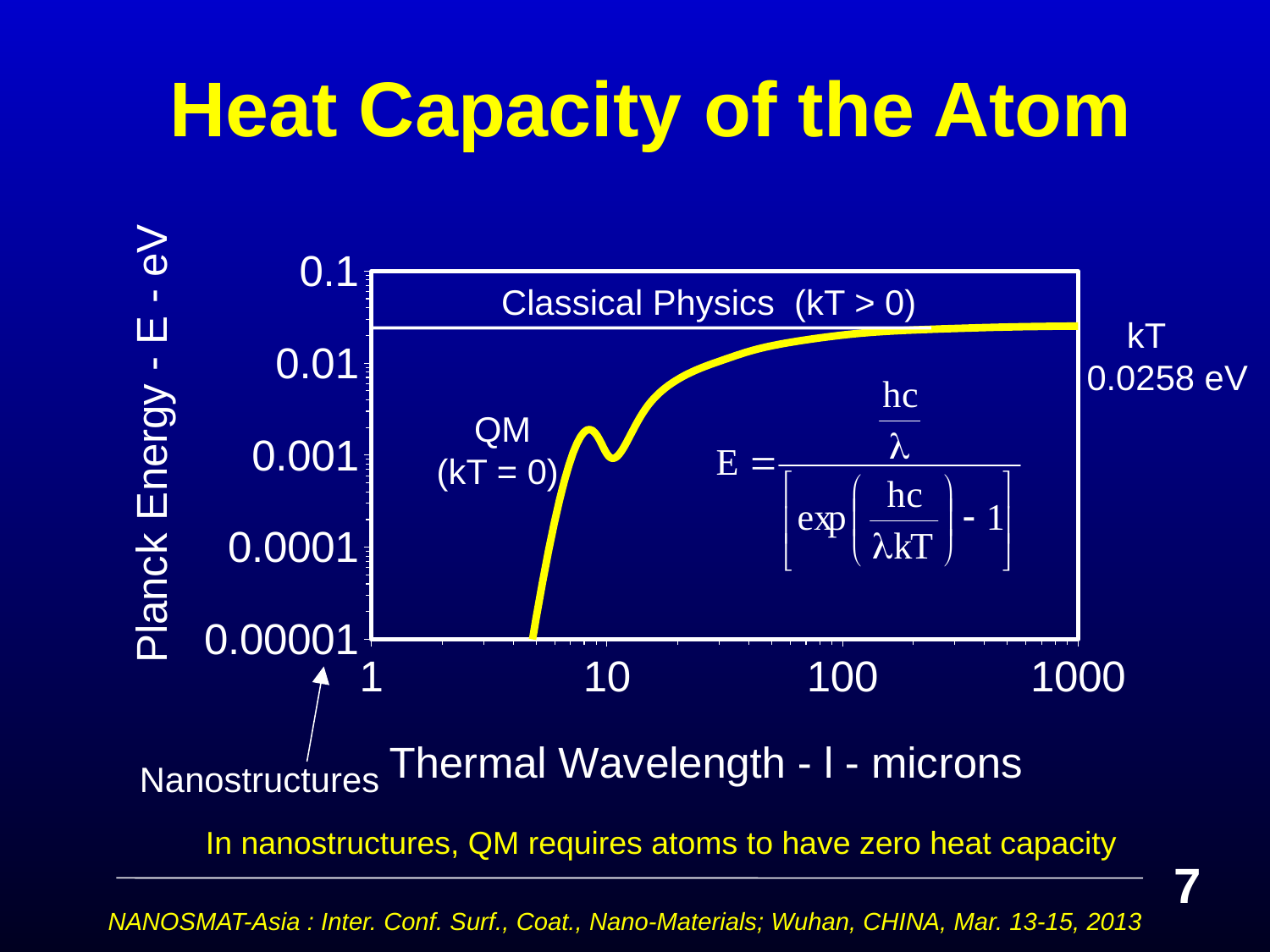
Is the Planck energy at a thermal wavelength of 10 microns greater or less than 0.01 eV? less Is the Planck energy at a thermal wavelength of 1000 microns greater or less than 0.1 eV? less What value of kT is printed next to the horizontal line on the chart? 0.0258 eV What is the label of the y axis of the chart? Planck Energy - E - eV How many labelled tick values are shown on the x axis of the chart? 4 Is the Planck energy at a thermal wavelength of 1000 microns greater or less than 0.01 eV? greater What kind of chart is shown on the slide? line chart What is the title of the slide containing the chart? Heat Capacity of the Atom Which is larger, the Planck energy at 100 microns or at 10 microns? 100 microns Does the Planck energy curve rise or fall as the thermal wavelength increases from 1 to 1000 microns? rise What is the lowest labelled value on the y axis of the chart? 0.00001